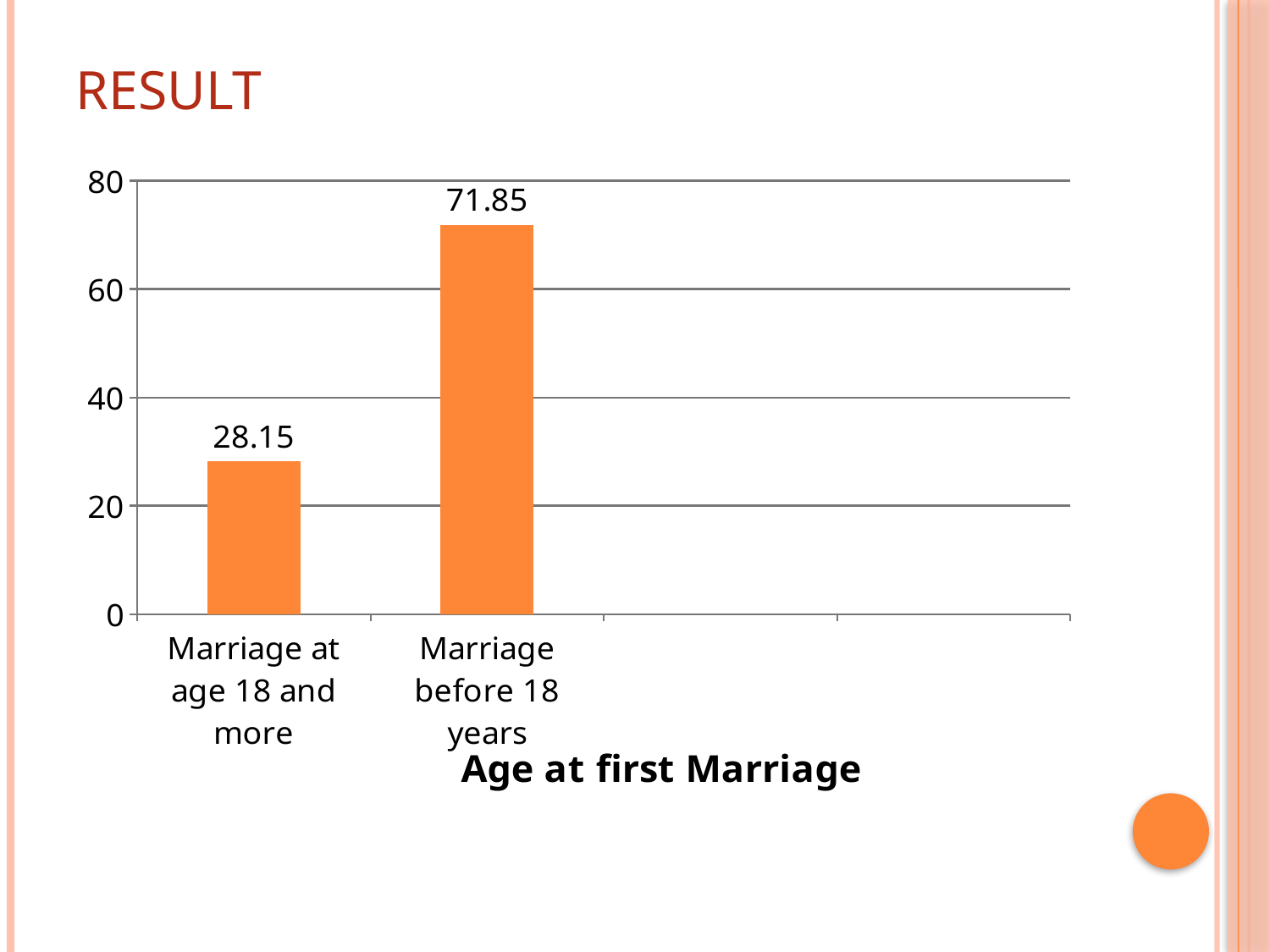
Is the value for "Marriage before 18 years" greater or less than 60? greater What is the value for "Marriage at age 18 and more"? 28.15 Which category has the lowest value? Marriage at age 18 and more What is the value for "Marriage before 18 years"? 71.85 What is the highest value shown on the y axis? 80 Which is larger: the value for "Marriage at age 18 and more" or the value for "Marriage before 18 years"? Marriage before 18 years Is the value for "Marriage at age 18 and more" greater or less than 40? less What is the difference between the values for "Marriage before 18 years" and "Marriage at age 18 and more"? 43.7 What is the label of the x axis? Age at first Marriage What kind of chart is shown on the slide? Bar chart Which category has the highest value? Marriage before 18 years How many categories are shown on the chart? 2